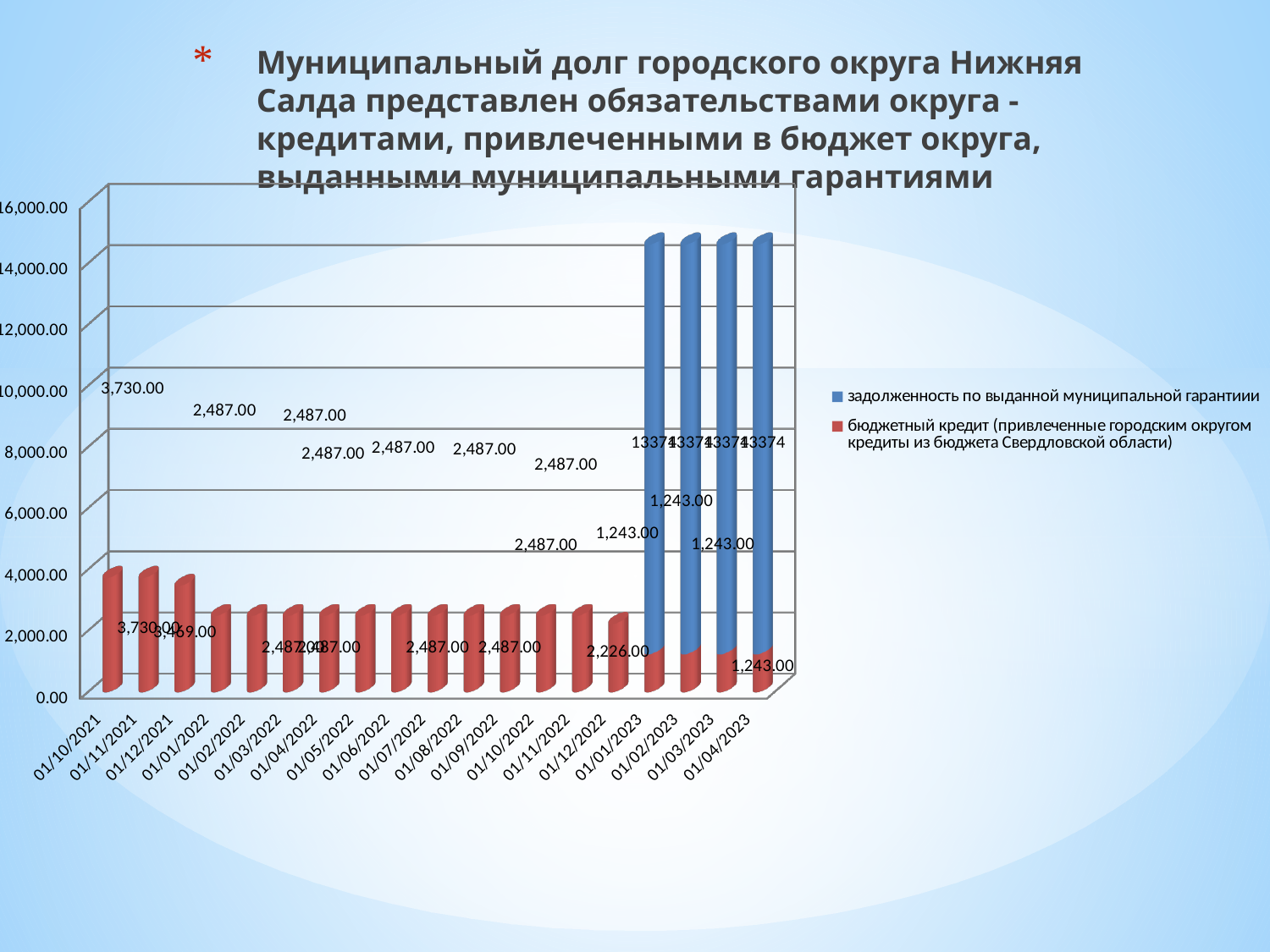
What is the value of the бюджетный кредит series for 01/12/2021? 3,469.00 How many dates are shown along the x axis? 19 What kind of chart is shown on the slide? bar chart How many series does the legend list? 2 Which colour represents the задолженность по выданной муниципальной гарантии series? blue What is the difference between the бюджетный кредит values for 01/10/2021 and 01/12/2022? 1,504.00 Does the бюджетный кредит series rise or fall from 01/10/2021 to 01/04/2023? fall Is the total stacked value for 01/01/2023 greater or less than 14,000.00? greater What is the value of the задолженность по выданной муниципальной гарантии series for 01/01/2023? 13374 What is the value of the бюджетный кредит series for 01/10/2021? 3,730.00 What is the value of the бюджетный кредит series for 01/12/2022? 2,226.00 Which is larger, the бюджетный кредит value for 01/10/2021 or for 01/12/2022? 01/10/2021